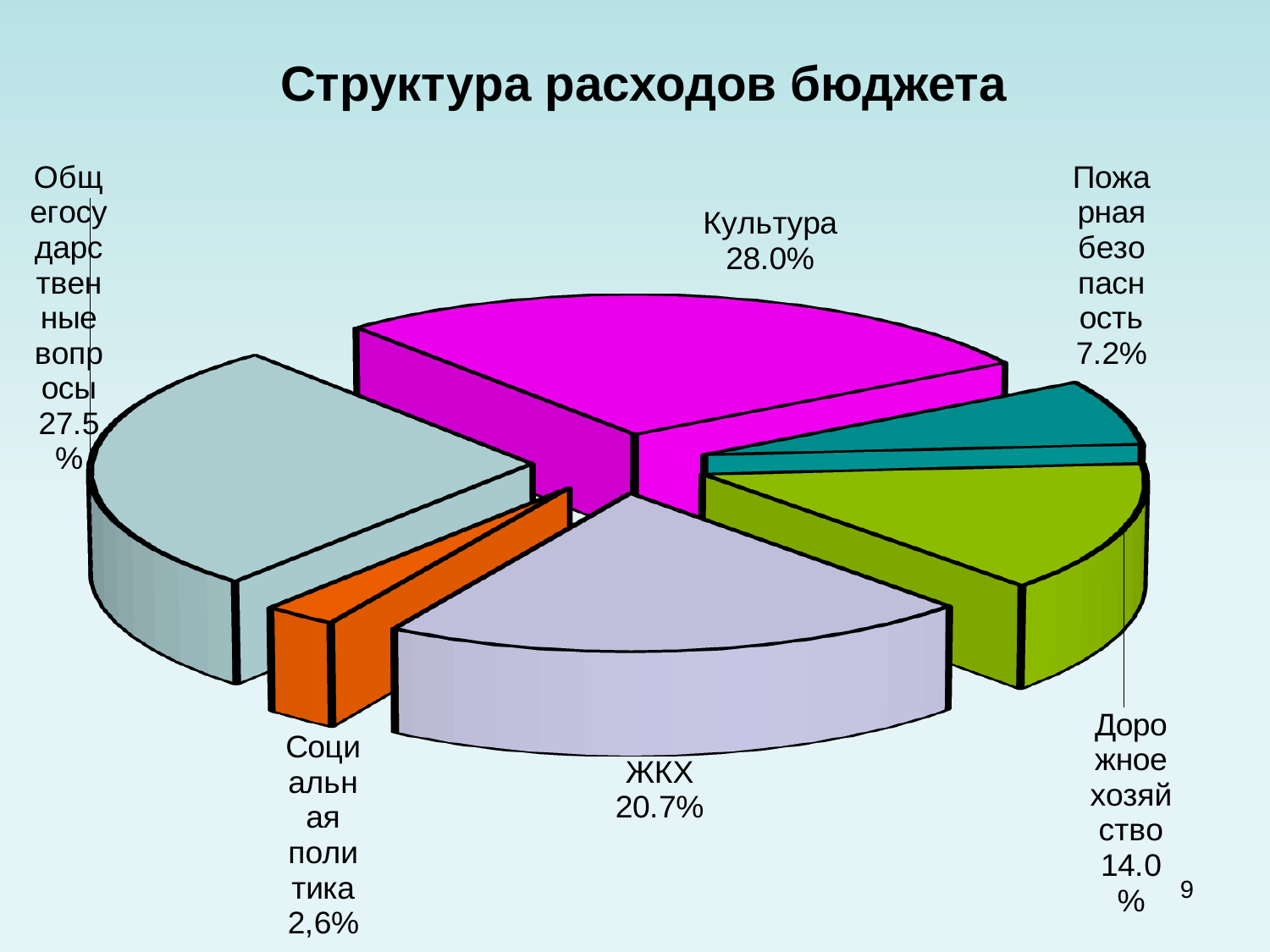
By how many percentage points does ЖКХ exceed Дорожное хозяйство? 6.7 What percentage is shown for Дорожное хозяйство? 14.0% Which category has the smallest share of the budget expenditure? Социальная политика What is the title of the chart? Структура расходов бюджета What share of the budget expenditure goes to Культура? 28.0% What is the value shown for ЖКХ? 20.7% What is the value for Общегосударственные вопросы? 27.5% Which is larger, the share for ЖКХ or the share for Дорожное хозяйство? ЖКХ How many slices does the pie chart have? 6 Which category has the largest share of the budget expenditure? Культура What kind of chart is shown on the slide? Pie chart What is the value for Пожарная безопасность? 7.2%